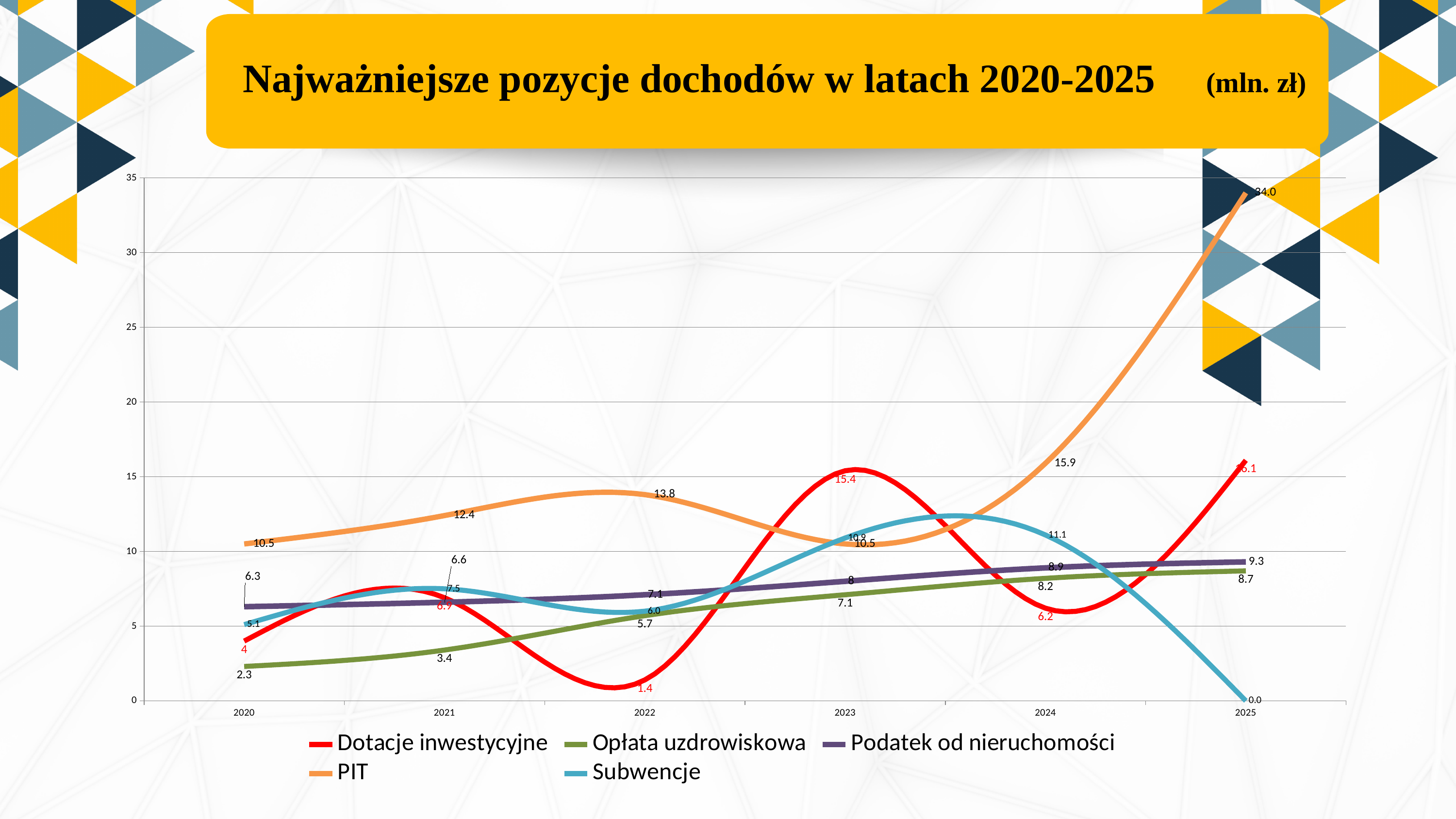
What is the value of Subwencje in 2025? 0.0 What is the value of Opłata uzdrowiskowa in 2020? 2.3 What is the value of Dotacje inwestycyjne in 2023? 15.4 In which year is PIT highest? 2025 How many series does the legend list? 5 In 2024, which is larger: Subwencje or Podatek od nieruchomości? Subwencje What kind of chart is shown on the slide? line chart What is the value of Podatek od nieruchomości in 2025? 9.3 What is the difference between the PIT values in 2025 and 2024? 18.1 What is the value of PIT in 2025? 34.0 In which year is Dotacje inwestycyjne lowest? 2022 Does Opłata uzdrowiskowa rise or fall from 2020 to 2025? rise